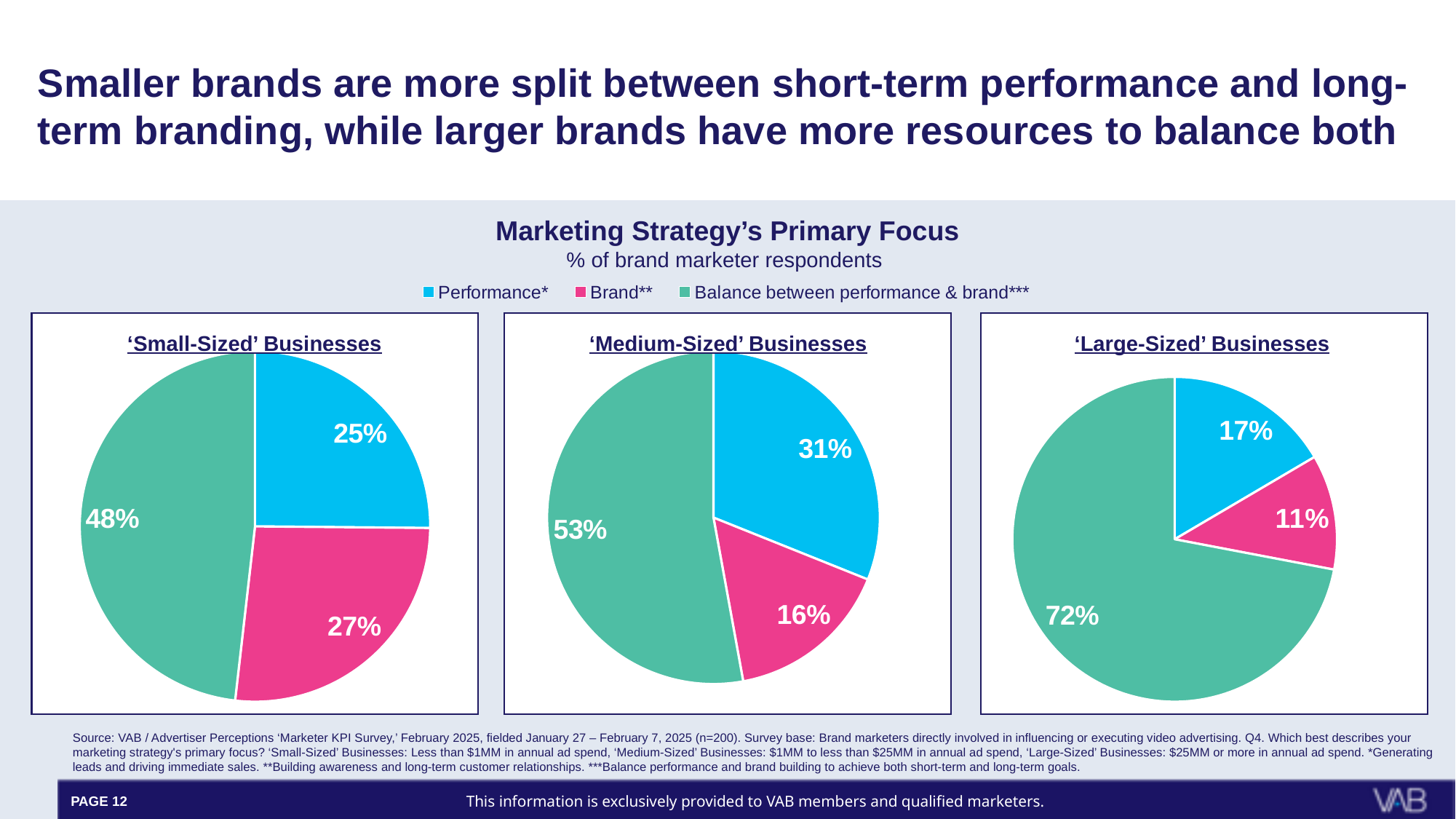
Comparing the Performance slices, which pie chart shows a higher value: 'Small-Sized' Businesses or 'Large-Sized' Businesses? 'Small-Sized' Businesses How many series does the legend list? 3 What is the title of the chart group on the slide? Marketing Strategy's Primary Focus In the 'Large-Sized' Businesses pie chart, what percentage of respondents chose Balance between performance & brand? 72% What type of chart is used for the 'Large-Sized' Businesses data? Pie chart In the 'Medium-Sized' Businesses pie chart, which is larger: Performance or Brand? Performance* In the 'Small-Sized' Businesses pie chart, what percentage of respondents chose Performance? 25% How many pie charts are shown on the slide? 3 In the 'Medium-Sized' Businesses pie chart, what percentage of respondents chose Brand? 16% In the 'Medium-Sized' Businesses pie chart, which category has the largest share? Balance between performance & brand*** In the 'Small-Sized' Businesses pie chart, what is the difference in percentage points between Balance between performance & brand and Brand? 21 In the 'Large-Sized' Businesses pie chart, which category has the smallest share? Brand**